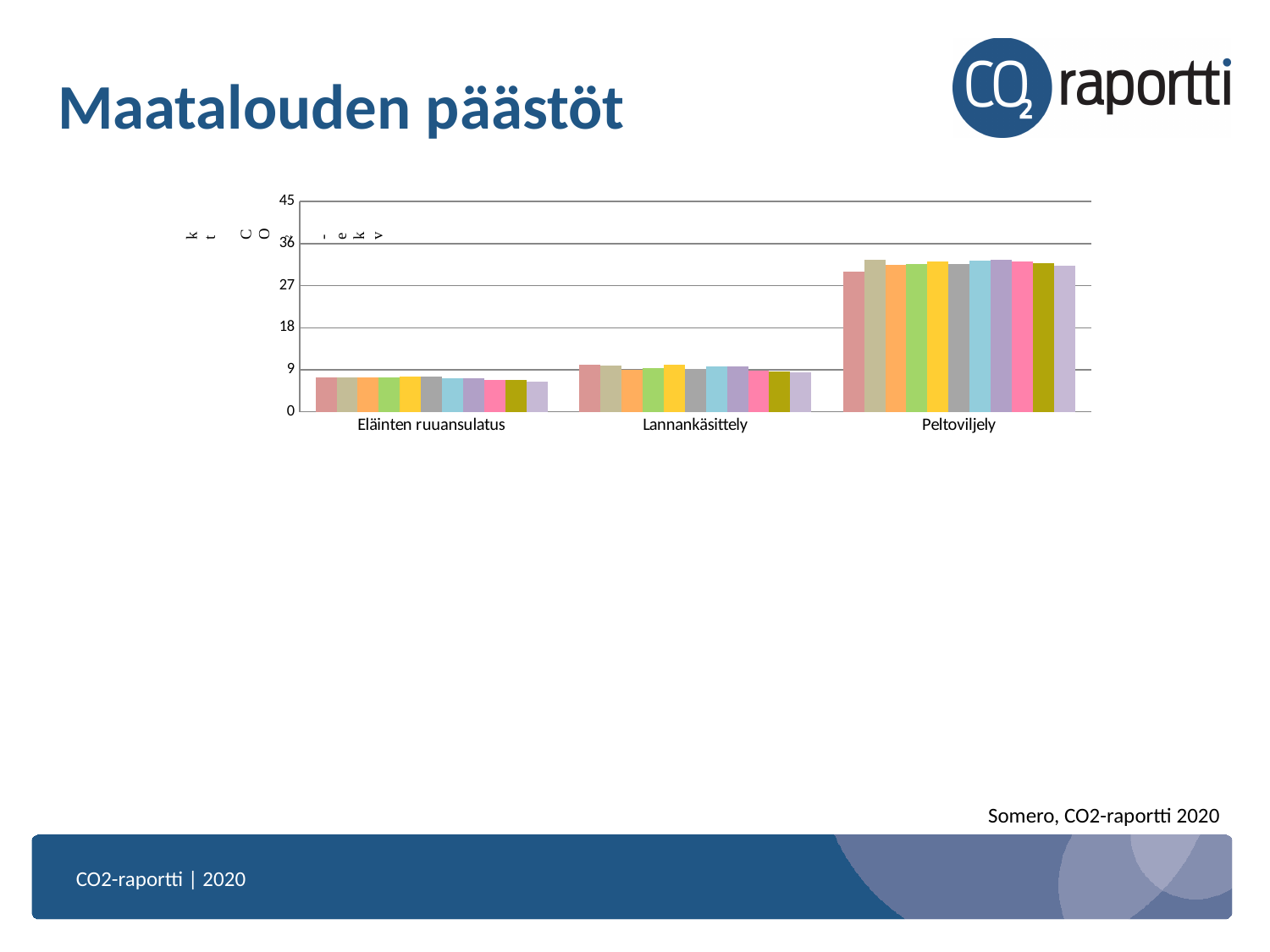
Are the values for Peltoviljely greater or less than 27? greater Which category has the highest values in the chart? Peltoviljely Are the values for Peltoviljely greater or less than 36? less Which category has larger values, Peltoviljely or Lannankäsittely? Peltoviljely What is the title of the slide containing the chart? Maatalouden päästöt Which category has larger values, Lannankäsittely or Eläinten ruuansulatus? Lannankäsittely Which category has the lowest values in the chart? Eläinten ruuansulatus Do the values rise or fall moving from left to right across the categories on the x axis? rise How many categories are shown on the x axis of the chart? 3 Are the values for Lannankäsittely greater or less than 18? less What kind of chart is shown on the slide? bar chart